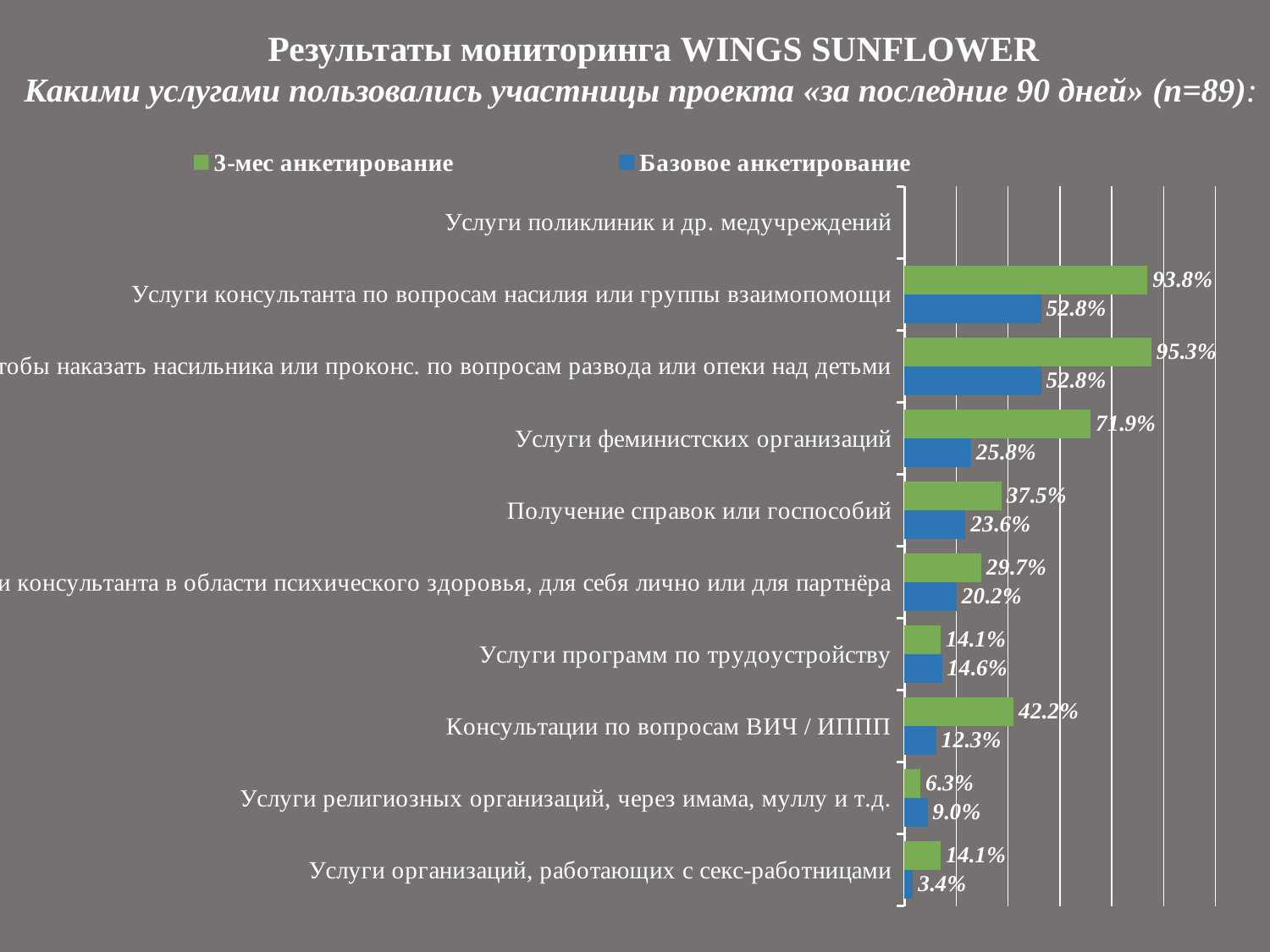
What is the 3-мес анкетирование value for Услуги консультанта по вопросам насилия или группы взаимопомощи? 93.8% Which category has the lowest Базовое анкетирование value? Услуги организаций, работающих с секс-работницами What type of chart is shown on the slide? bar chart Which category has the lowest 3-мес анкетирование value? Услуги религиозных организаций, через имама, муллу и т.д. Which colour represents the 3-мес анкетирование series? green What is the difference between the 3-мес анкетирование and Базовое анкетирование values for Консультации по вопросам ВИЧ / ИППП? 29.9% What is the Базовое анкетирование value for Консультации по вопросам ВИЧ / ИППП? 12.3% What is the 3-мес анкетирование value for Услуги феминистских организаций? 71.9% What is the Базовое анкетирование value for Услуги организаций, работающих с секс-работницами? 3.4% For Услуги религиозных организаций, через имама, муллу и т.д., which is larger: the 3-мес анкетирование value or the Базовое анкетирование value? Базовое анкетирование What is the difference between the 3-мес анкетирование and Базовое анкетирование values for Услуги феминистских организаций? 46.1% How many series does the legend list? 2